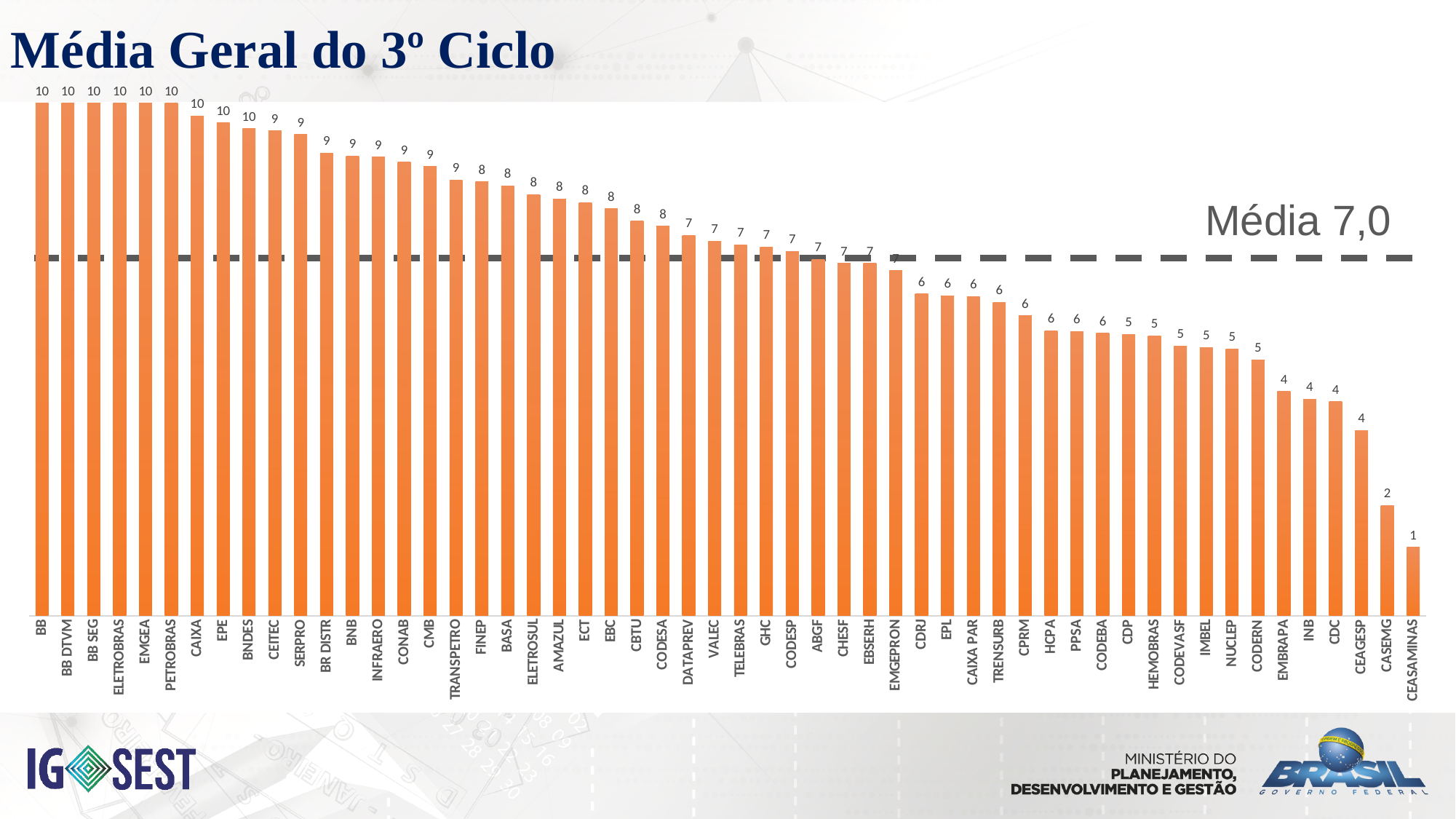
What is the difference between the values for BB and CEASAMINAS? 9 What value is shown for FINEP? 8 Do the values rise or fall from left to right along the x axis? fall What kind of chart is this? bar chart What value is shown for CDP? 5 Which has a larger value, CDRJ or CEAGESP? CDRJ What value is shown for EMBRAPA? 4 Which category has the lowest value? CEASAMINAS What label is shown next to the dashed horizontal line? Média 7,0 How many categories are shown on the x axis? 54 What value is shown for CASEMG? 2 What is the difference between the values for CASEMG and CEASAMINAS? 1